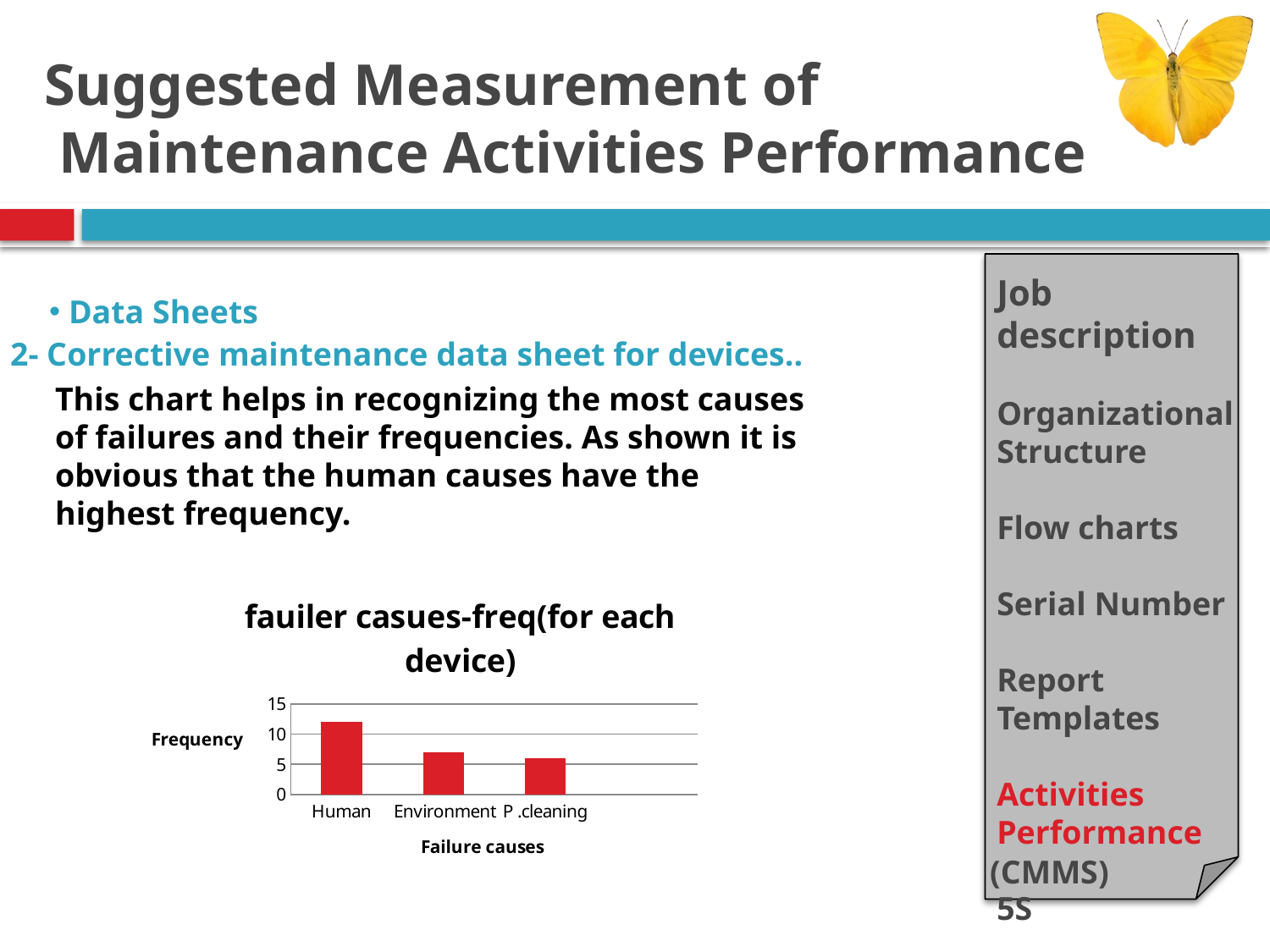
What kind of chart is shown on the slide? bar chart Is the frequency for Human greater or less than 15? less How many failure cause categories are plotted in the chart? 3 Which failure cause has the highest frequency in the chart? Human Is the frequency for P .cleaning greater or less than 10? less Do the frequencies rise or fall moving from left to right across the categories? fall Is the frequency for Environment greater or less than 5? greater What is the label on the horizontal axis of the chart? Failure causes Which has a higher frequency, Human or Environment? Human What is the title of the chart? fauiler casues-freq(for each device)